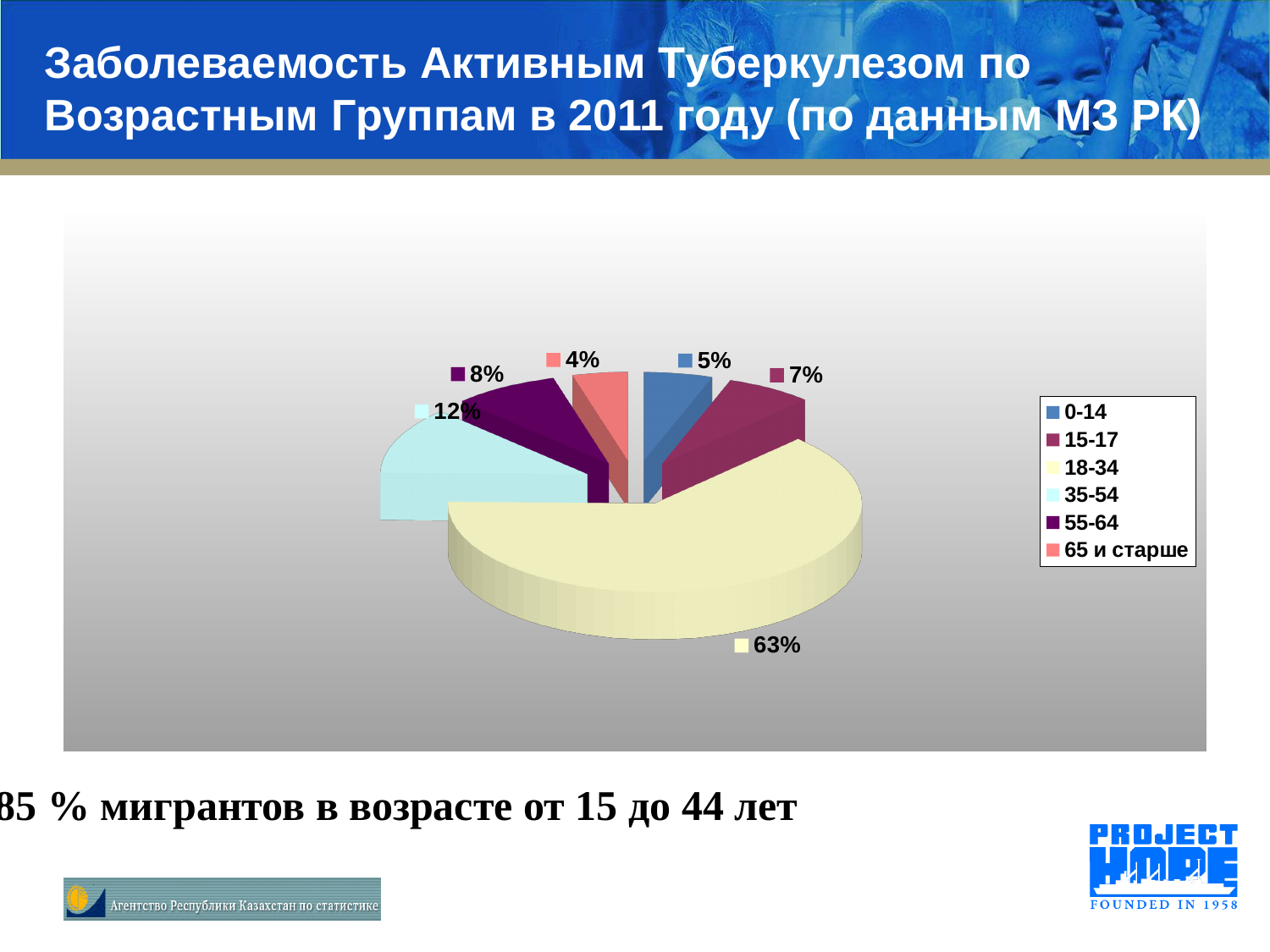
What share of the pie does the 35-54 age group have? 12% What share of the pie does the 65 и старше age group have? 4% Which age group has the smallest share of the pie? 65 и старше What share of the pie does the 18-34 age group have? 63% What is the combined share of the 0-14 and 15-17 slices? 12% Which age group has the largest share of the pie? 18-34 What is the difference in percentage points between the 18-34 and 35-54 slices? 51 How many age groups are shown in the pie chart? 6 Which slice is larger, 15-17 or 55-64? 55-64 Which legend entry is shown in light yellow? 18-34 What kind of chart is shown on the slide? Pie chart What share of the pie does the 0-14 age group have? 5%